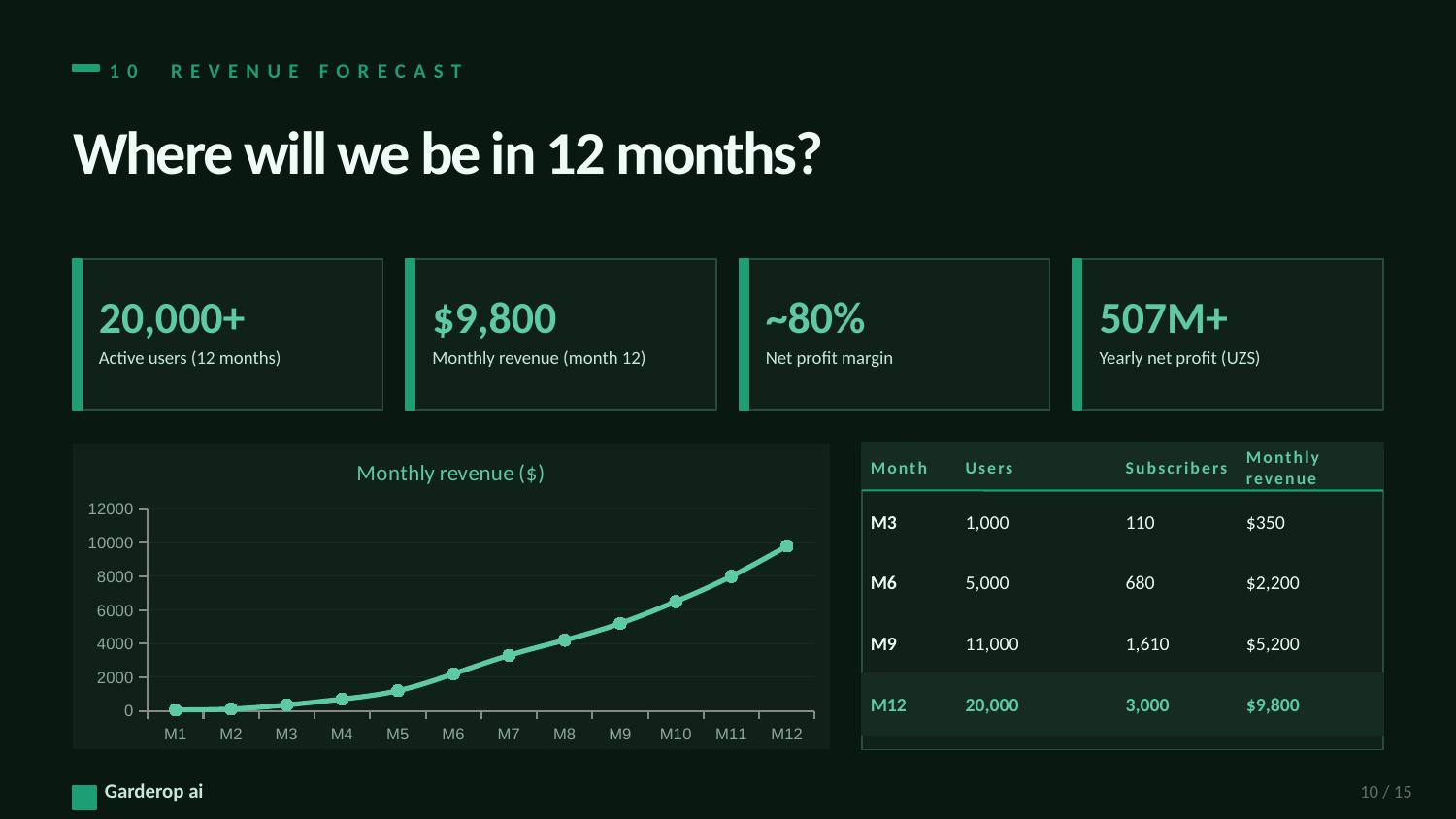
Is the value for M5 greater or less than 2000? less Is the value for M9 greater or less than 4000? greater What is the highest value shown on the y axis of the chart? 12000 How many months are plotted on the x axis of the chart? 12 What is the title of the chart? Monthly revenue ($) What kind of chart is shown on the slide? line chart Which month has the highest value in the chart? M12 Is the value for M10 greater or less than 6000? greater Do the values in the chart rise or fall from M1 to M12? rise Which is larger in the chart, the value for M10 or the value for M5? M10